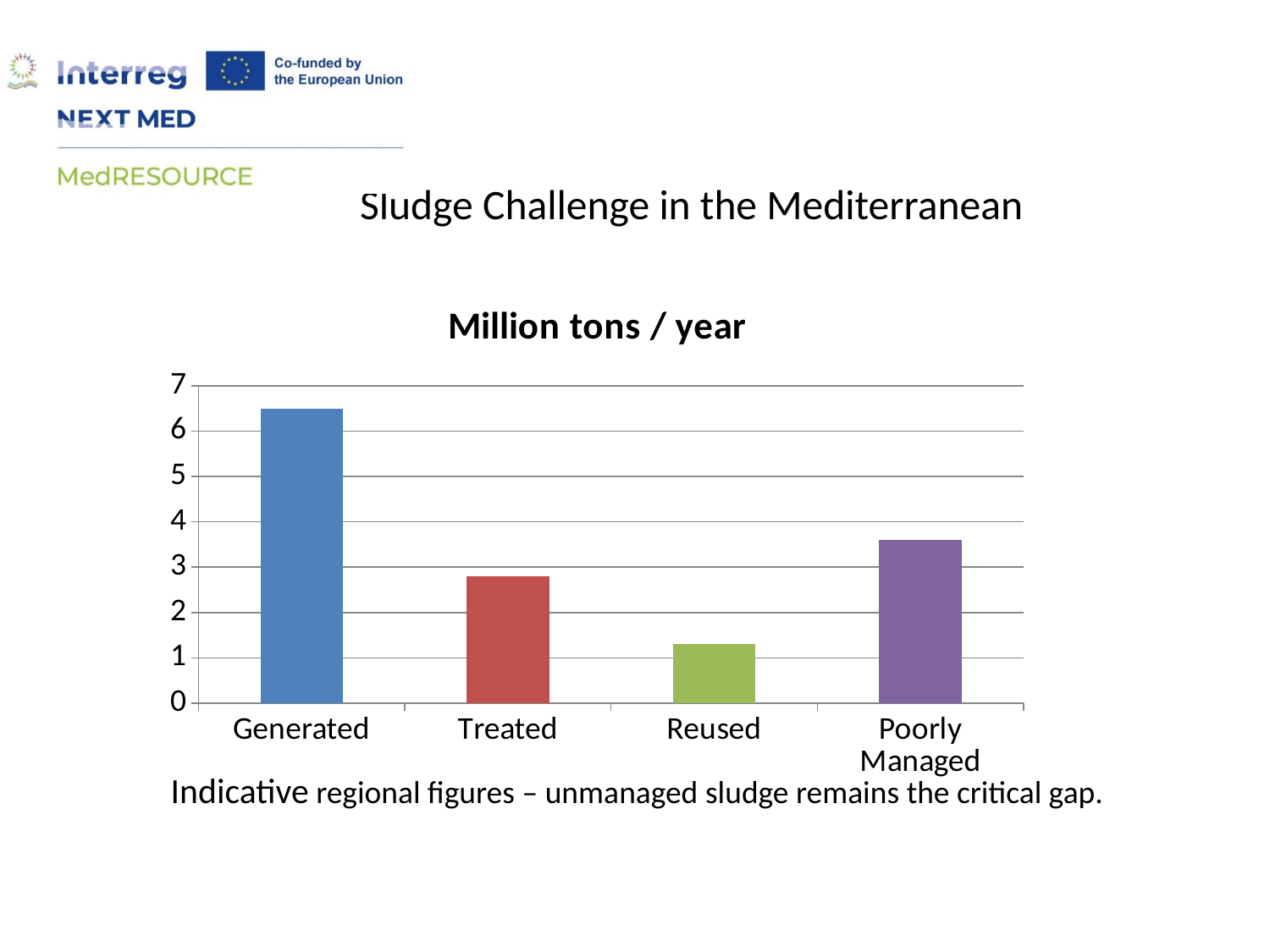
How many categories are shown on the x axis of the chart? 4 Which category has the lowest value? Reused What kind of chart is shown on the slide? bar chart Is the value for Treated greater or less than 3? less Which is larger, the value for Poorly Managed or the value for Treated? Poorly Managed Which is larger, the value for Treated or the value for Reused? Treated What is the title of the chart? Million tons / year Which category has the highest value? Generated Is the value for Reused greater or less than 2? less Is the value for Poorly Managed greater or less than 3? greater What colour is the bar for Generated? blue